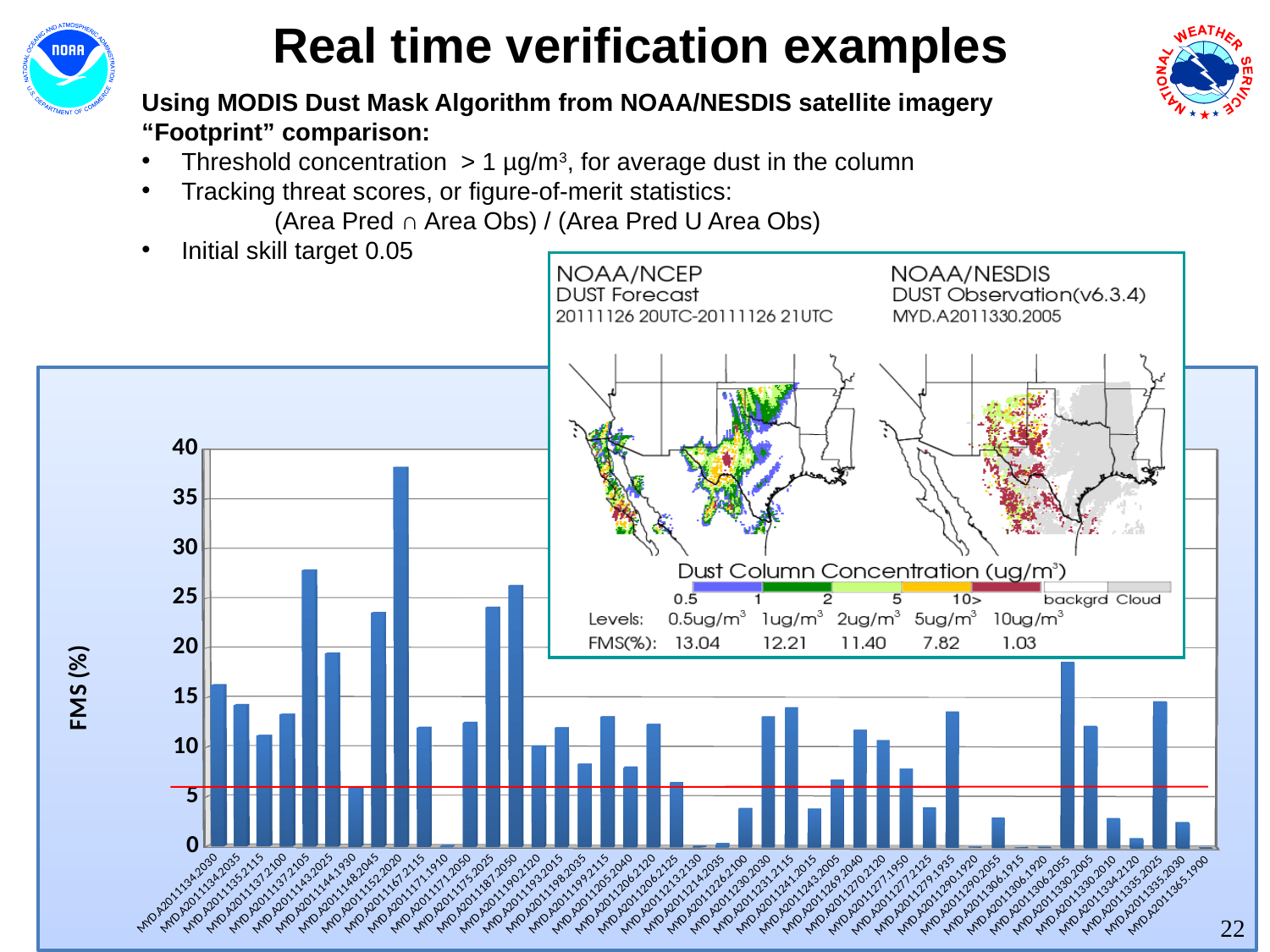
Is the value for MYD.A2011144.1930 greater or less than 10? less What is the label on the y-axis of the bar chart? FMS (%) Which has the larger value, MYD.A2011137.2105 or MYD.A2011134.2030? MYD.A2011137.2105 What is the highest tick value shown on the y-axis of the bar chart? 40 Is the value for MYD.A2011134.2030 greater or less than 10? greater Is the value for MYD.A2011152.2020 greater or less than 35? greater In the inset table of the dust comparison image, what is the difference between the FMS(%) for 0.5ug/m³ and 10ug/m³? 12.01 Which category has the tallest bar in the FMS (%) bar chart? MYD.A2011152.2020 What kind of chart is shown at the bottom of the slide? bar chart In the inset table of the dust comparison image, which level has the highest FMS(%)? 0.5ug/m³ In the inset table of the dust comparison image, what is the FMS(%) for the 1ug/m³ level? 12.21